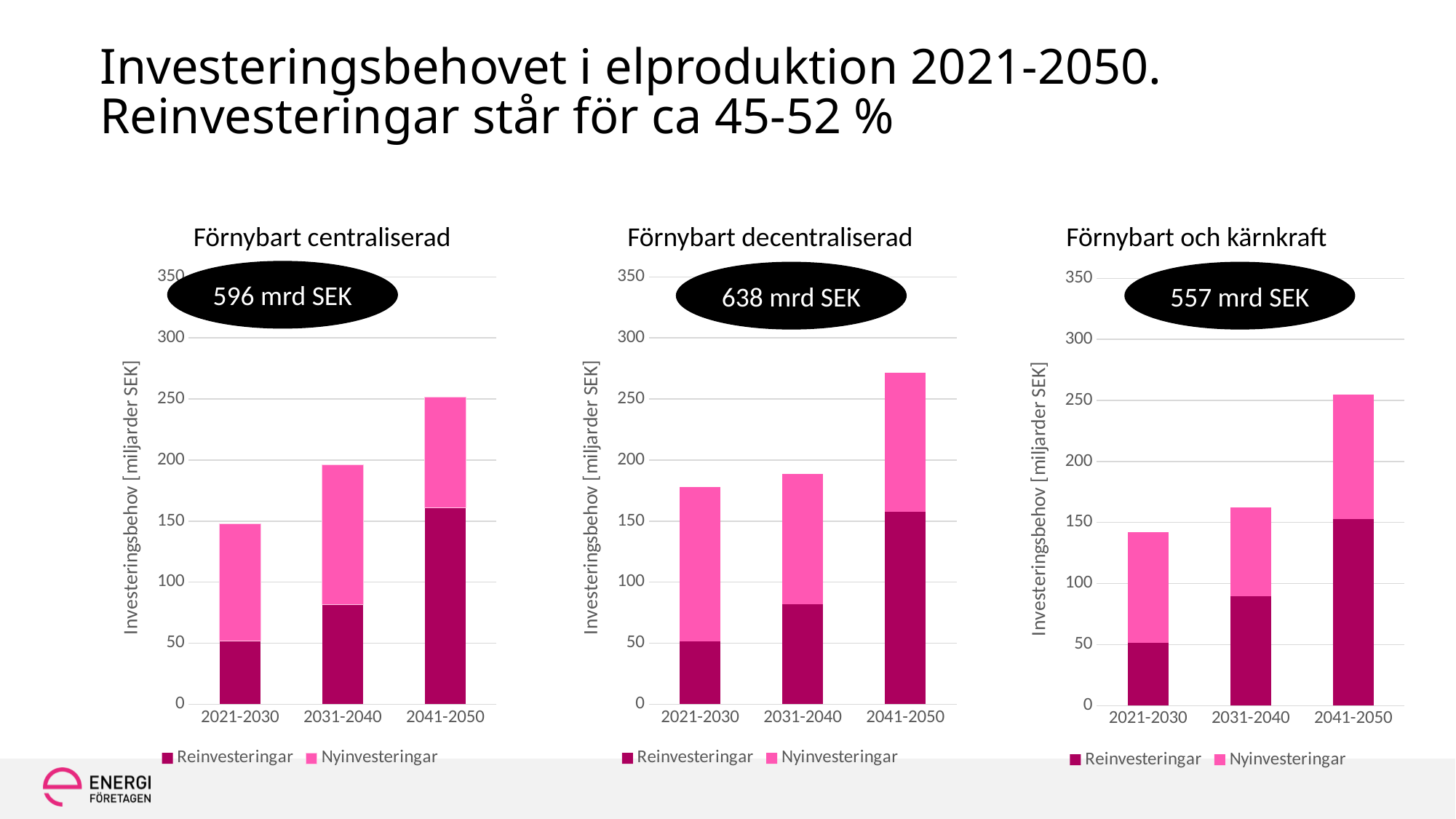
In the "Förnybart och kärnkraft" chart, is the total bar for 2021-2030 greater or less than 150? less What kind of chart is used for "Förnybart centraliserad"? Stacked bar chart How many series does the legend of the "Förnybart och kärnkraft" chart list? 2 How many time periods are shown on the x axis of the "Förnybart decentraliserad" chart? 3 In the "Förnybart decentraliserad" chart, is the total bar for 2021-2030 greater or less than 150? greater In the "Förnybart och kärnkraft" chart, which period has the lowest total investment need? 2021-2030 In the "Förnybart decentraliserad" chart, is the Reinvesteringar segment for 2041-2050 greater or less than 100? greater In the "Förnybart decentraliserad" chart, do the total bars rise or fall from 2021-2030 to 2041-2050? rise In the "Förnybart centraliserad" chart, which period has the highest total investment need? 2041-2050 Which is larger: the total bar for 2031-2040 in the "Förnybart centraliserad" chart or the total bar for 2031-2040 in the "Förnybart och kärnkraft" chart? Förnybart centraliserad What total amount is shown in the black oval on the "Förnybart decentraliserad" chart? 638 mrd SEK